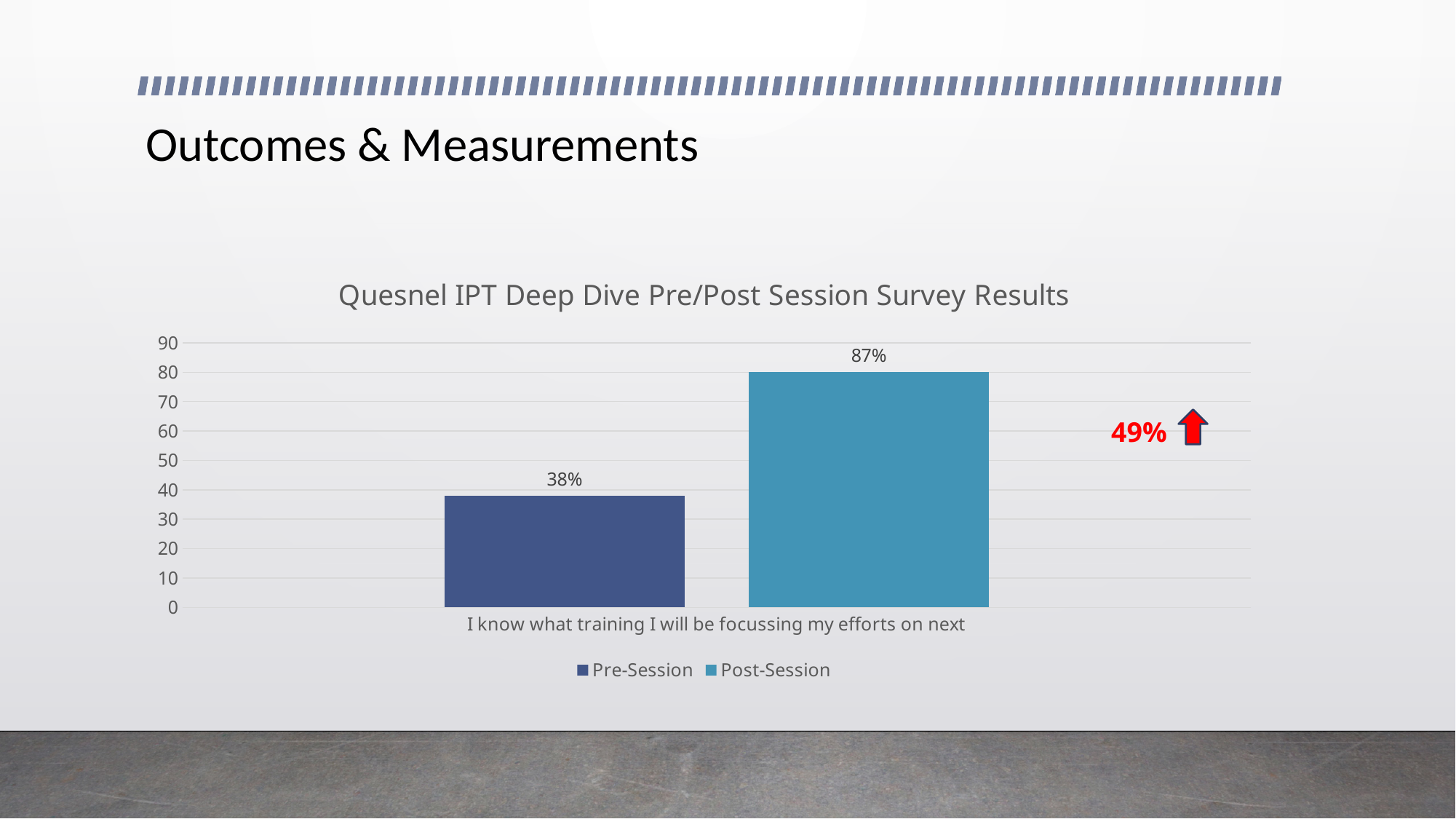
How many categories are shown on the x axis? 1 How many series does the legend list? 2 What is the maximum value shown on the vertical axis? 90 What is the title of the chart? Quesnel IPT Deep Dive Pre/Post Session Survey Results What kind of chart is shown on the slide? Bar chart What is the Pre-Session value for "I know what training I will be focussing my efforts on next"? 38% Is the Pre-Session value greater or less than 40? less What is the difference between the Post-Session and Pre-Session values? 49% Which series has the higher value, Pre-Session or Post-Session? Post-Session Which series has the lowest value? Pre-Session What is the Post-Session value for "I know what training I will be focussing my efforts on next"? 87%